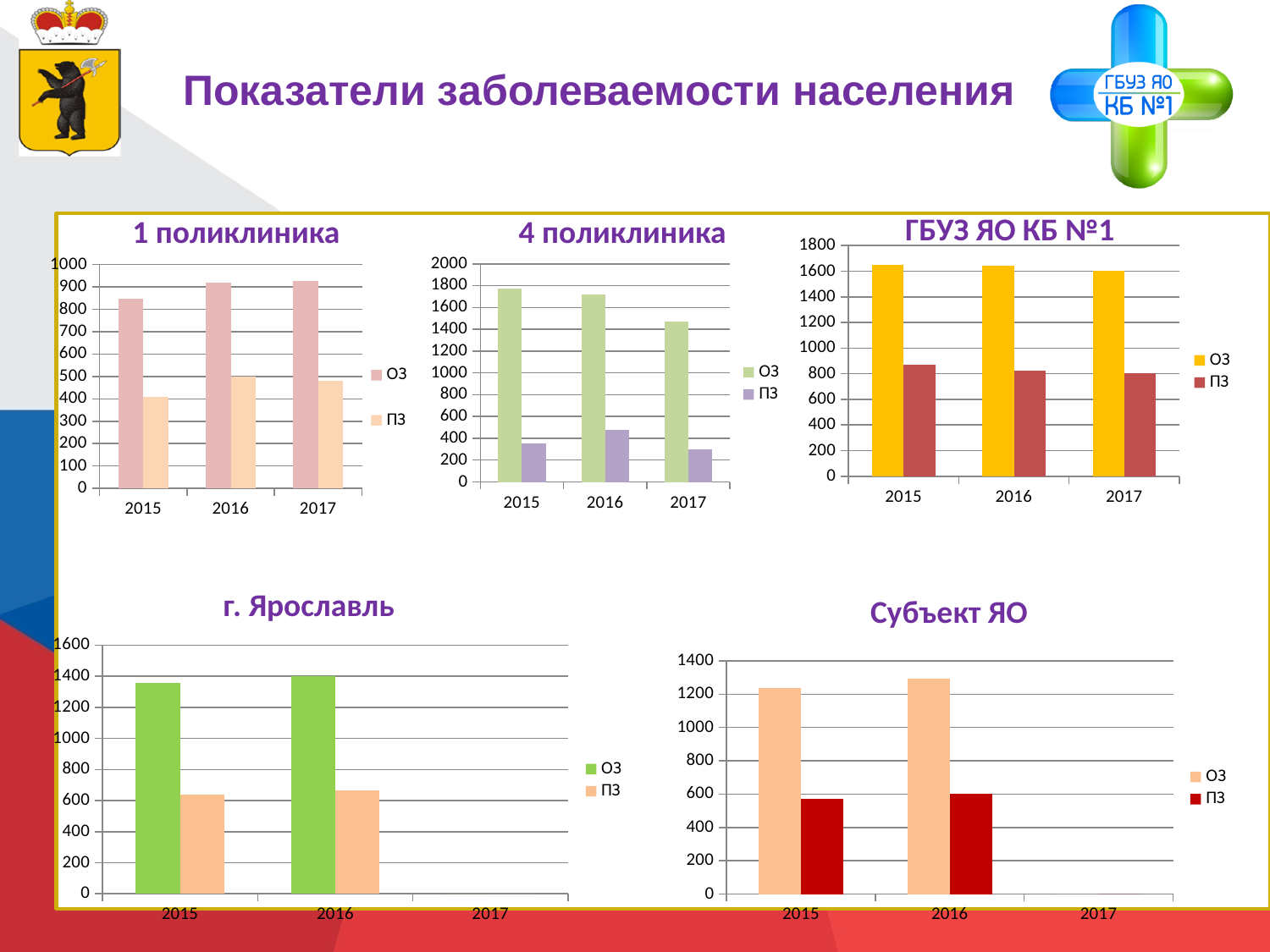
In the "ГБУЗ ЯО КБ №1" chart, which is larger for 2015, ОЗ or ПЗ? ОЗ In the "4 поликлиника" chart, which year has the highest ПЗ value? 2016 In the "1 поликлиника" chart, is the ОЗ value for 2015 greater or less than 800? greater In the "1 поликлиника" chart, which year has the lowest ПЗ value? 2015 What kind of chart is the "1 поликлиника" chart? bar chart In the "4 поликлиника" chart, do the ОЗ values rise or fall from 2015 to 2017? fall In the "4 поликлиника" chart, is the ОЗ value for 2017 greater or less than 1600? less In the "Субъект ЯО" chart, is the ОЗ value for 2016 greater or less than 1200? greater How many years are shown on the x axis of the "г. Ярославль" chart? 3 How many charts are shown on the slide? 5 How many series does the legend of the "4 поликлиника" chart list? 2